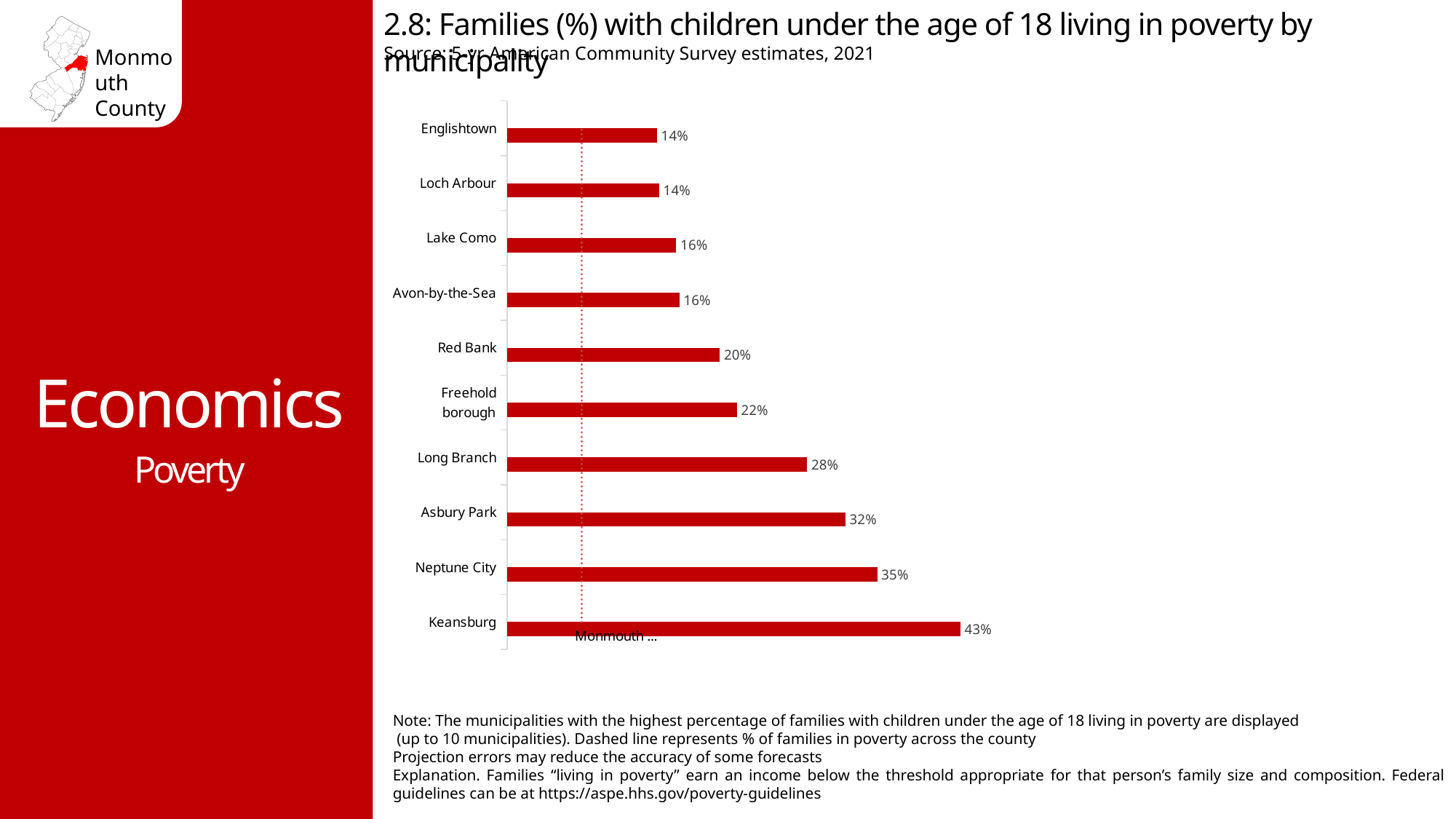
According to the note, what does the dashed line on the chart represent? % of families in poverty across the county Which municipality has the highest percentage of families with children under 18 living in poverty? Keansburg How many municipalities are shown on the chart? 10 What is the value shown for Red Bank? 20% What is the difference between the values for Keansburg and Neptune City? 8 percentage points What is the value shown for Freehold borough? 22% What is the value shown for Long Branch? 28% What type of chart is used on this slide? Bar chart Which has a higher value, Neptune City or Asbury Park? Neptune City Which municipality has the lowest value on the chart? Englishtown and Loch Arbour (both 14%) What percentage of families with children under 18 are living in poverty in Keansburg? 43% What is the difference between the values for Asbury Park and Red Bank? 12 percentage points